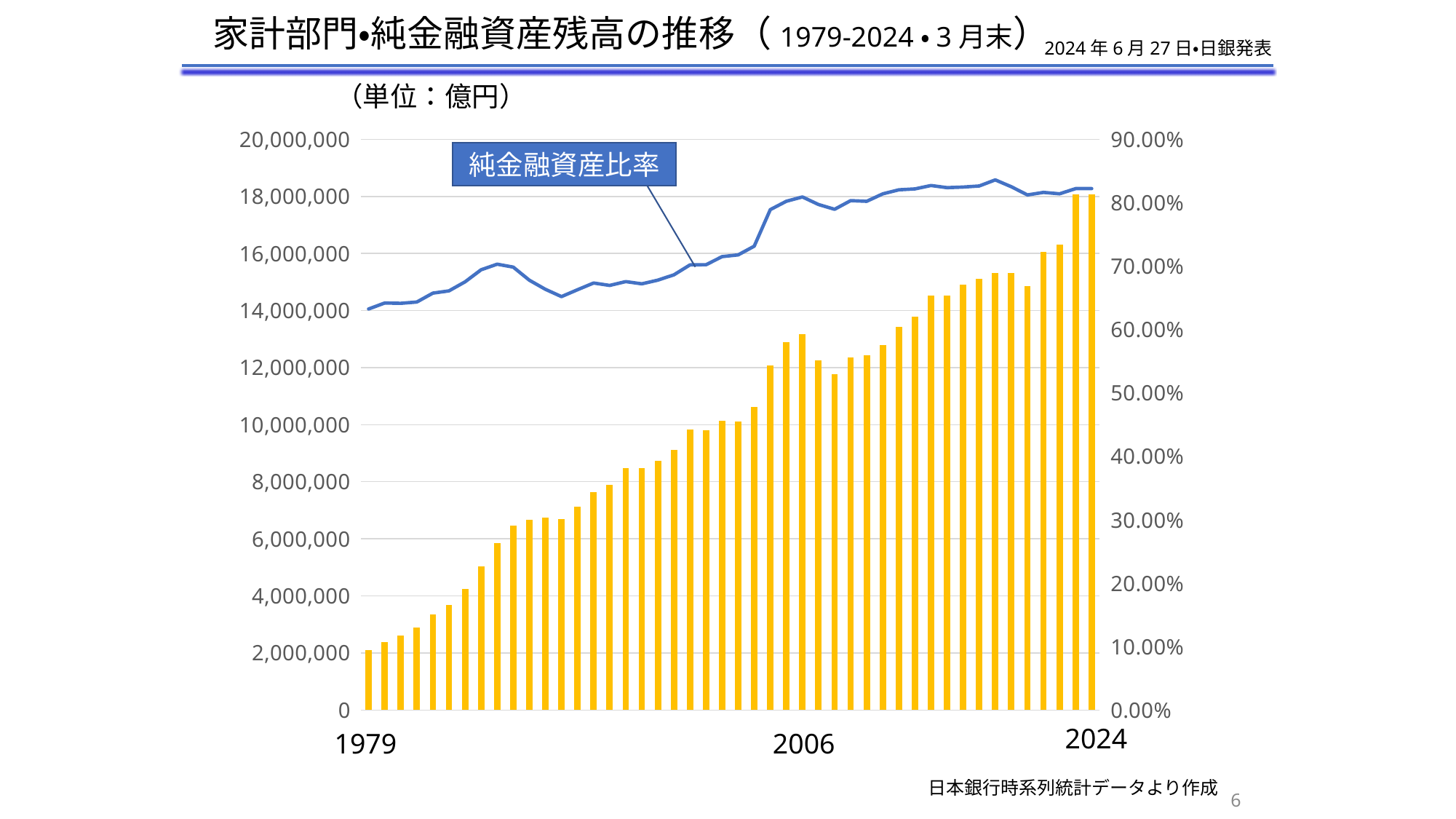
What kind of chart is shown on the slide? A bar chart with a line overlay What is the label given to the line series in the chart? 純金融資産比率 Is the 純金融資産比率 line value for 2024 greater or less than 70.00%? greater Is the 純金融資産比率 line value for 1979 greater or less than 70.00%? less Is the bar value for 2006 greater or less than 10,000,000? greater Do the bars for net financial assets generally rise or fall from 1979 to 2024? Rise Which year has the lowest bar value? 1979 Which bar is larger, 1979 or 2024? 2024 What unit is stated for the bar values on the slide? 億円 How many bars are plotted in the chart? 46